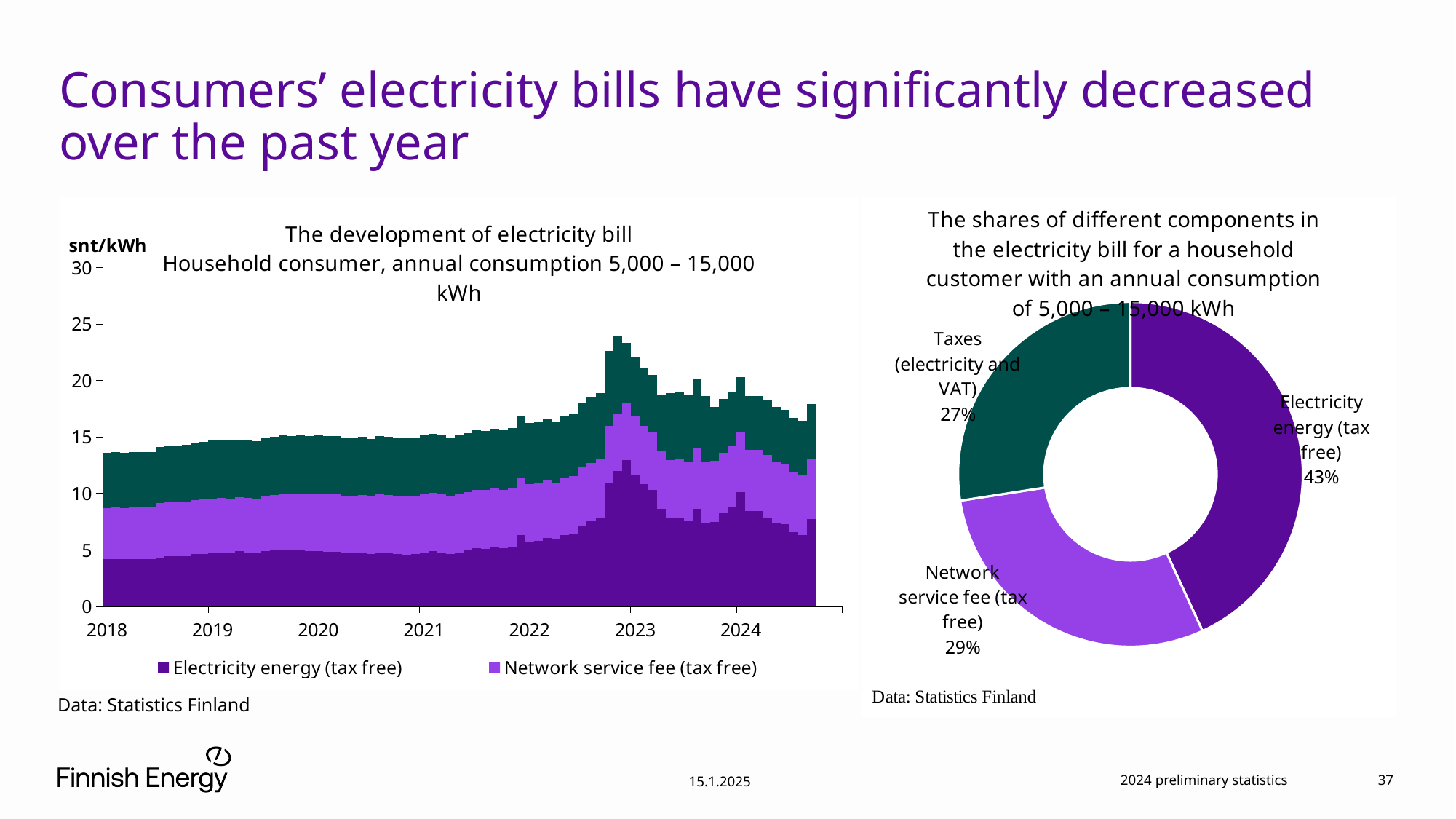
In the chart on the left, 'The development of electricity bill', how many series does the legend list? 2 What kind of chart is the chart on the right of the slide? Pie chart (doughnut) In the chart on the left, what unit is shown on the vertical axis? snt/kWh In the chart on the left, 'The development of electricity bill', is the total electricity bill at the start of 2018 greater or less than 15 snt/kWh? less In the pie chart on the right, which component has the smallest share of the electricity bill? Taxes (electricity and VAT) In the pie chart on the right, how many percentage points larger is the Electricity energy share than the Network service fee share? 14 In the pie chart on the right, which component has the largest share of the electricity bill? Electricity energy (tax free) In the pie chart on the right, what share of the electricity bill is Taxes (electricity and VAT)? 27% In the chart on the left, 'The development of electricity bill', is the peak total electricity bill around the end of 2022 greater or less than 20 snt/kWh? greater In the pie chart on the right, what share of the electricity bill is the Network service fee (tax free)? 29% In the pie chart on the right, what share of the electricity bill is Electricity energy (tax free)? 43% In the pie chart on the right, how many components are shown? 3